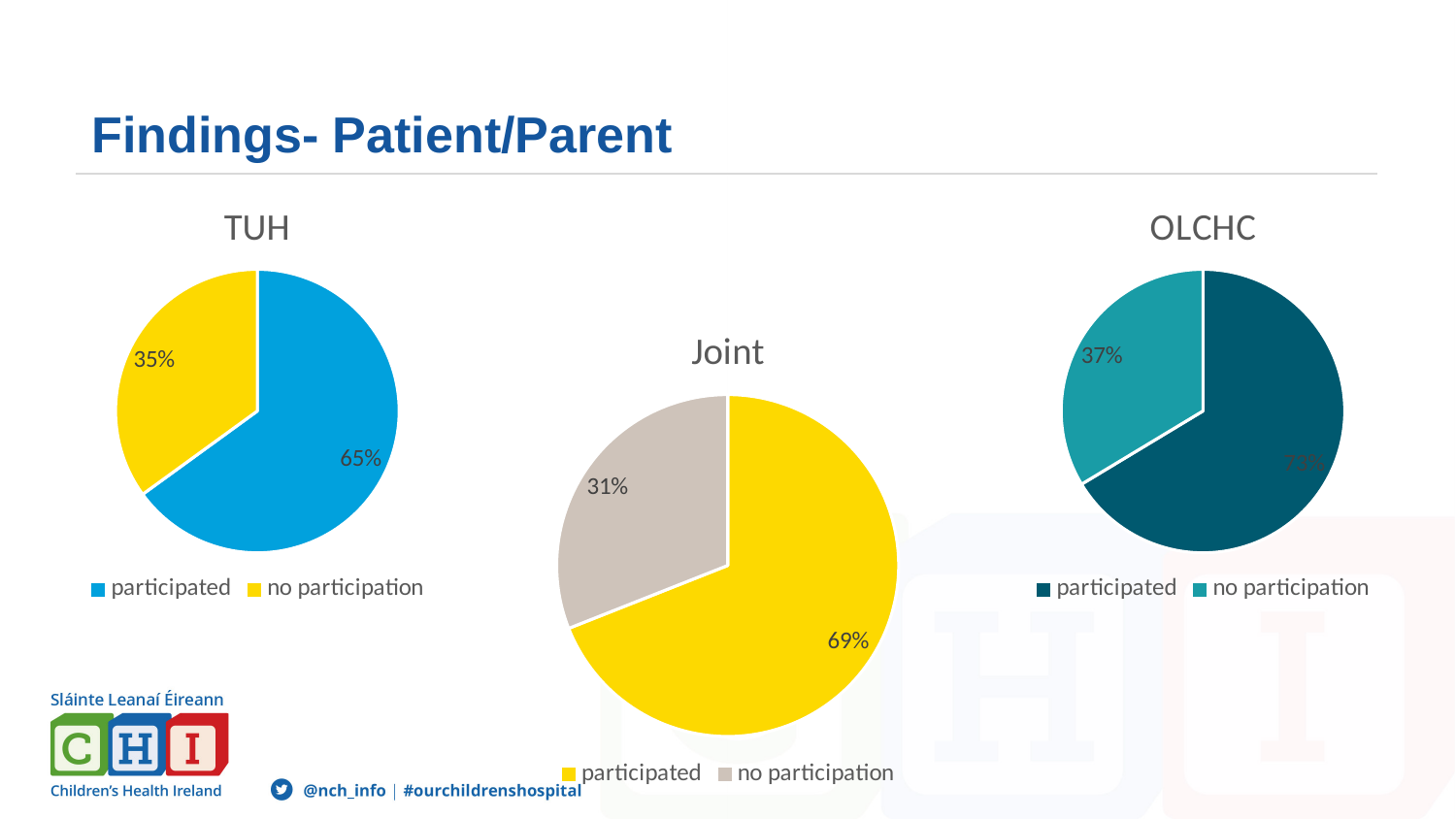
In the OLCHC pie chart, which is larger, participated or no participation? participated In the TUH pie chart, which slice is the largest? participated In the TUH pie chart, what is the difference between the participated and no participation percentages? 30% What type of chart is used for the Joint data? pie chart In the TUH pie chart, what percentage is shown for no participation? 35% In the Joint pie chart, what percentage participated? 69% In the Joint pie chart, what percentage is shown for no participation? 31% How many slices does the Joint pie chart have? 2 In the Joint pie chart, which slice is the smallest? no participation How many entries does the legend of the OLCHC pie chart list? 2 In the TUH pie chart, what percentage participated? 65% In the OLCHC pie chart, what percentage is shown for no participation? 37%